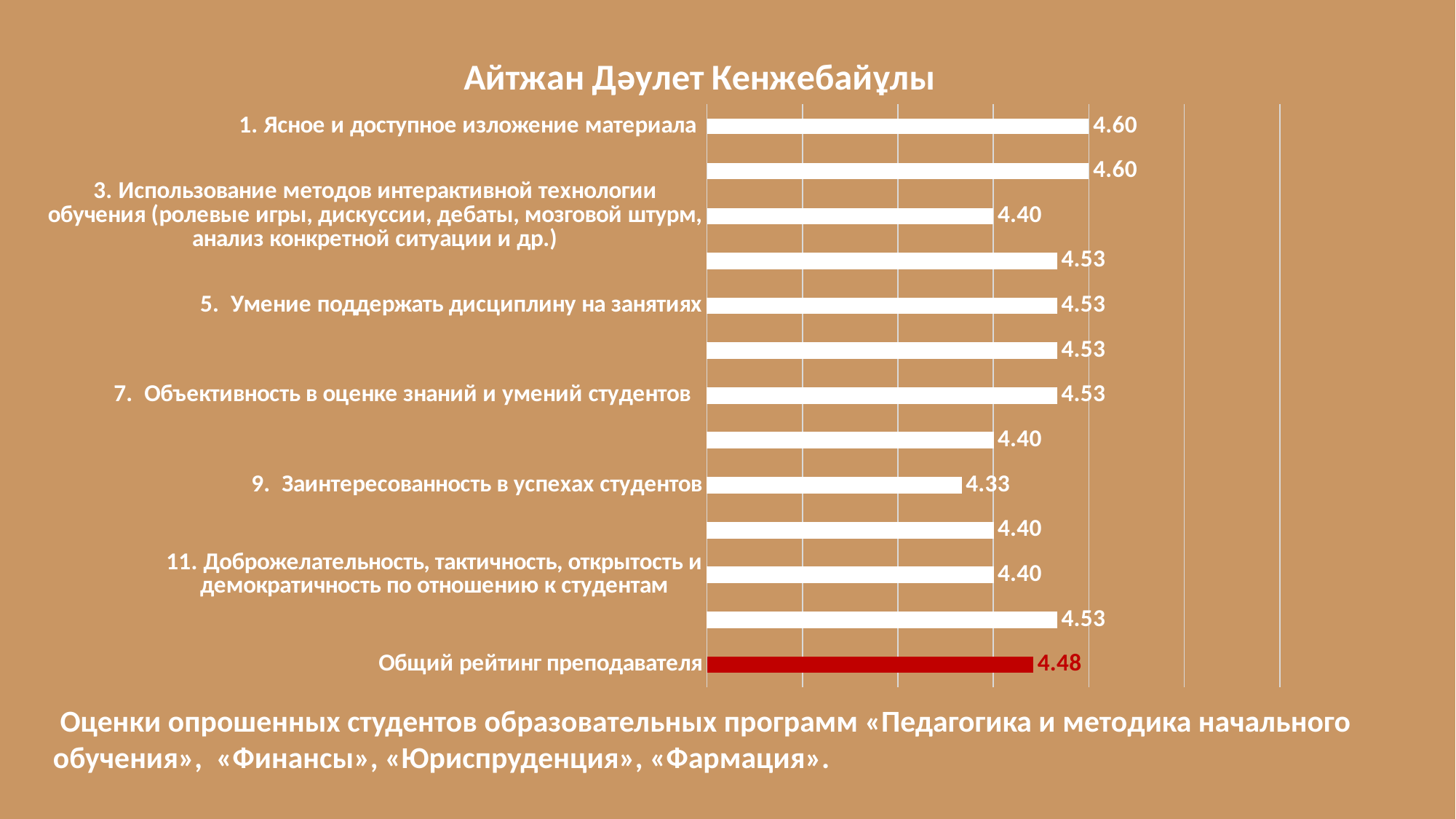
What is the value for "5. Умение поддержать дисциплину на занятиях"? 4.53 What colour is the bar for "Общий рейтинг преподавателя"? Red What is the title of the chart? Айтжан Дәулет Кенжебайұлы What is the value for "1. Ясное и доступное изложение материала"? 4.60 What is the difference between the value for "1. Ясное и доступное изложение материала" and the value for "9. Заинтересованность в успехах студентов"? 0.27 What kind of chart is shown on the slide? Bar chart What is the value for "9. Заинтересованность в успехах студентов"? 4.33 What is the value for "11. Доброжелательность, тактичность, открытость и демократичность по отношению к студентам"? 4.40 Which is larger: the value for "7. Объективность в оценке знаний и умений студентов" or the value for "11. Доброжелательность, тактичность, открытость и демократичность по отношению к студентам"? 7. Объективность в оценке знаний и умений студентов What is the value for "Общий рейтинг преподавателя"? 4.48 Which category has the lowest value in the chart? 9. Заинтересованность в успехах студентов How many bars are plotted in the chart? 13